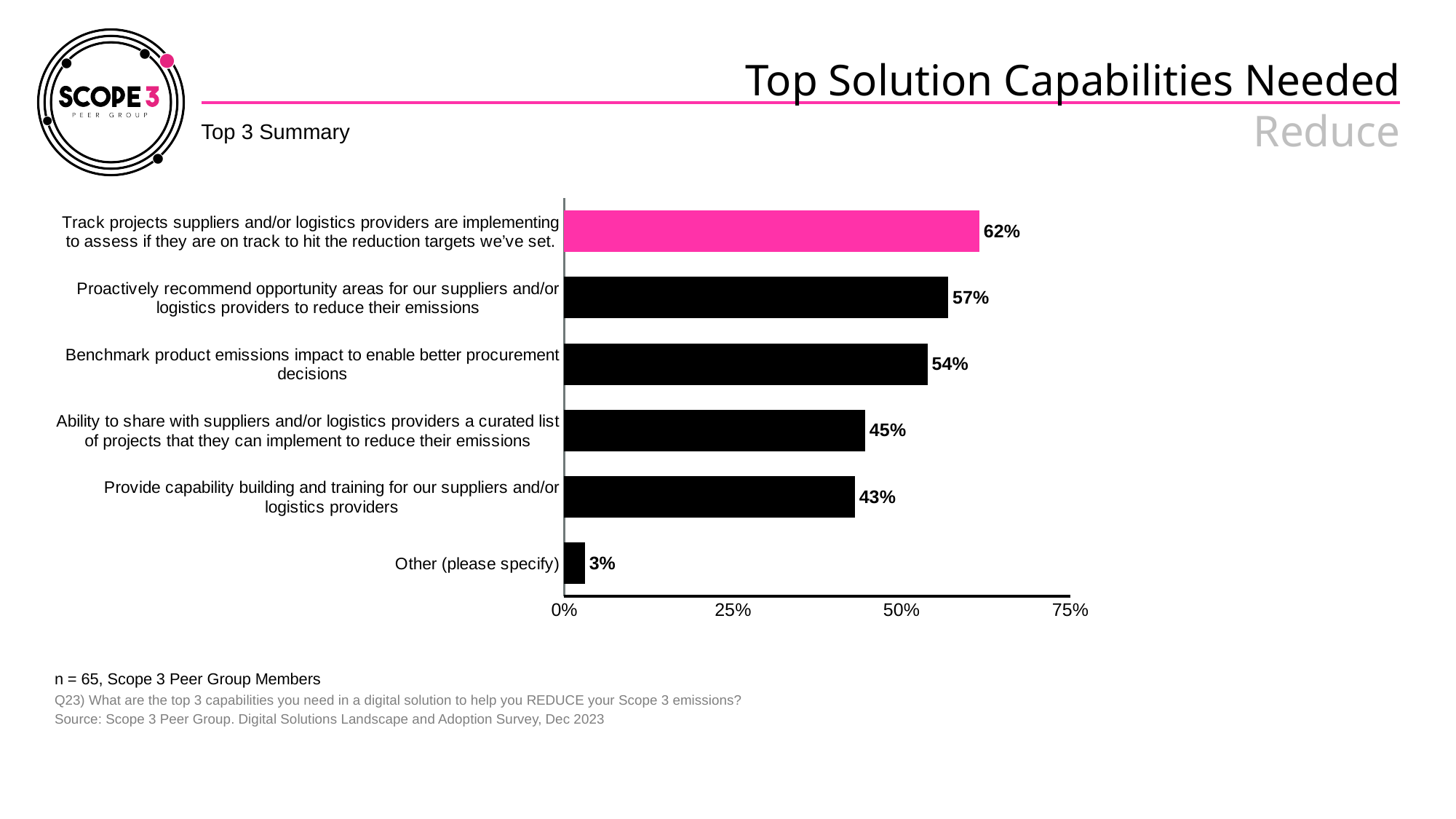
Which is larger: the value for 'Benchmark product emissions impact to enable better procurement decisions' or the value for 'Provide capability building and training for our suppliers and/or logistics providers'? Benchmark product emissions impact to enable better procurement decisions What is the difference between the values for 'Proactively recommend opportunity areas for our suppliers and/or logistics providers to reduce their emissions' and 'Ability to share with suppliers and/or logistics providers a curated list of projects that they can implement to reduce their emissions'? 12% What is the sample size (n) stated on the slide? 65 Is the value for 'Ability to share with suppliers and/or logistics providers a curated list of projects that they can implement to reduce their emissions' greater or less than 50%? less Which category has the highest value? Track projects suppliers and/or logistics providers are implementing to assess if they are on track to hit the reduction targets we've set. Which category has the lowest value? Other (please specify) How many categories are shown in the chart? 6 What is the value for 'Benchmark product emissions impact to enable better procurement decisions'? 54% What kind of chart is shown on the slide? Bar chart What is the value for 'Provide capability building and training for our suppliers and/or logistics providers'? 43% Which bar is highlighted in pink? Track projects suppliers and/or logistics providers are implementing to assess if they are on track to hit the reduction targets we've set. What percentage of respondents selected 'Track projects suppliers and/or logistics providers are implementing to assess if they are on track to hit the reduction targets we've set'? 62%